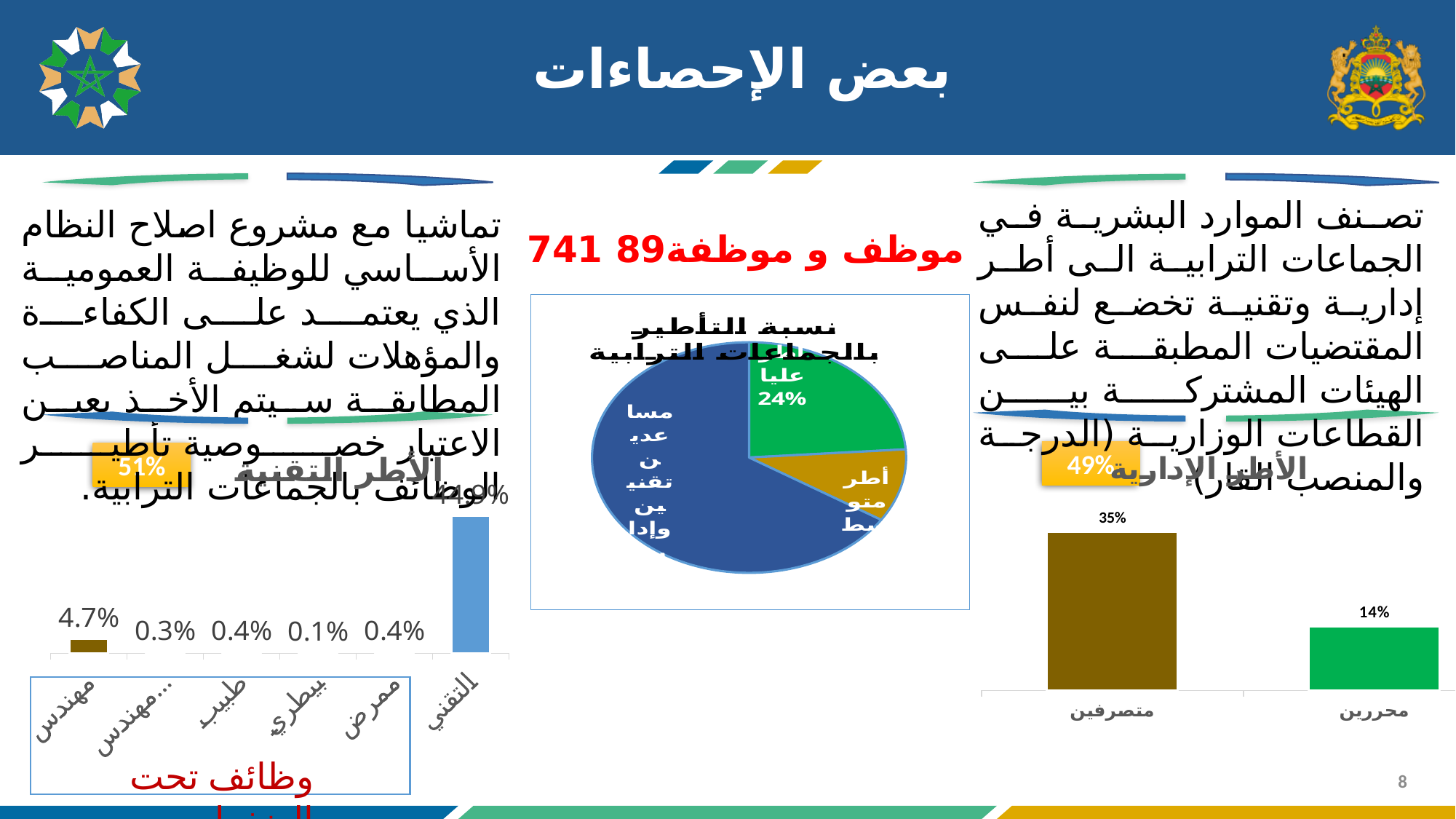
In the bar chart titled الأطر التقنية on the left, what is the value for مهندس? 4.7% In the bar chart titled الأطر التقنية on the left, which category has the highest value? التقني What kind of chart is the chart in the centre of the slide? pie chart In the pie chart in the centre of the slide, what share does the slice labelled عليا have? 24% In the bar chart titled الأطر التقنية on the left, is the value for مهندس larger or smaller than the value for ممرض? larger In the bar chart titled الأطر الإدارية on the right, which category has the higher value? متصرفين In the bar chart titled الأطر الإدارية on the right, what is the value for محررين? 14% In the bar chart titled الأطر الإدارية on the right, what is the value for متصرفين? 35% In the bar chart titled الأطر الإدارية on the right, what is the difference between the values for متصرفين and محررين? 21% How many categories are shown in the bar chart titled الأطر الإدارية on the right? 2 In the bar chart titled الأطر التقنية on the left, which category has the lowest value? بيطري In the bar chart titled الأطر التقنية on the left, what is the value for بيطري? 0.1%